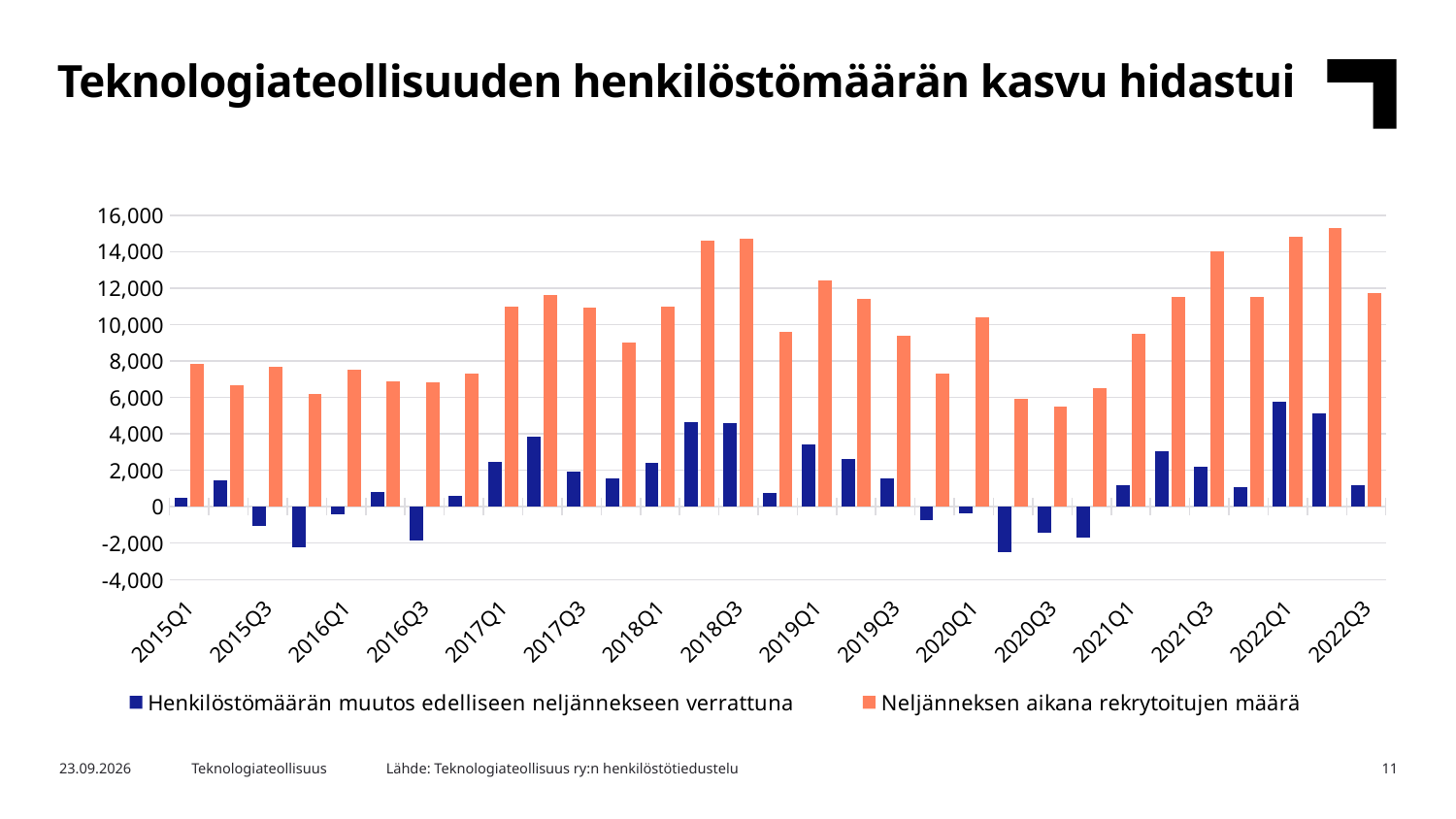
What kind of chart is shown on the slide? Bar chart Do the values of 'Neljänneksen aikana rekrytoitujen määrä' rise or fall from 2020Q3 to 2022Q1? rise Is the value of 'Henkilöstömäärän muutos edelliseen neljännekseen verrattuna' for 2016Q3 greater or less than 0? less Which is larger for 'Neljänneksen aikana rekrytoitujen määrä': 2018Q3 or 2015Q1? 2018Q3 Which colour represents 'Neljänneksen aikana rekrytoitujen määrä' in the chart? Orange Is the value of 'Henkilöstömäärän muutos edelliseen neljännekseen verrattuna' for 2022Q1 greater or less than 4,000? greater How many series does the legend list? 2 Which is larger for 'Henkilöstömäärän muutos edelliseen neljännekseen verrattuna': 2022Q1 or 2015Q1? 2022Q1 Is the value of 'Neljänneksen aikana rekrytoitujen määrä' for 2015Q1 greater or less than 6,000? greater How many category labels are shown on the x axis? 16